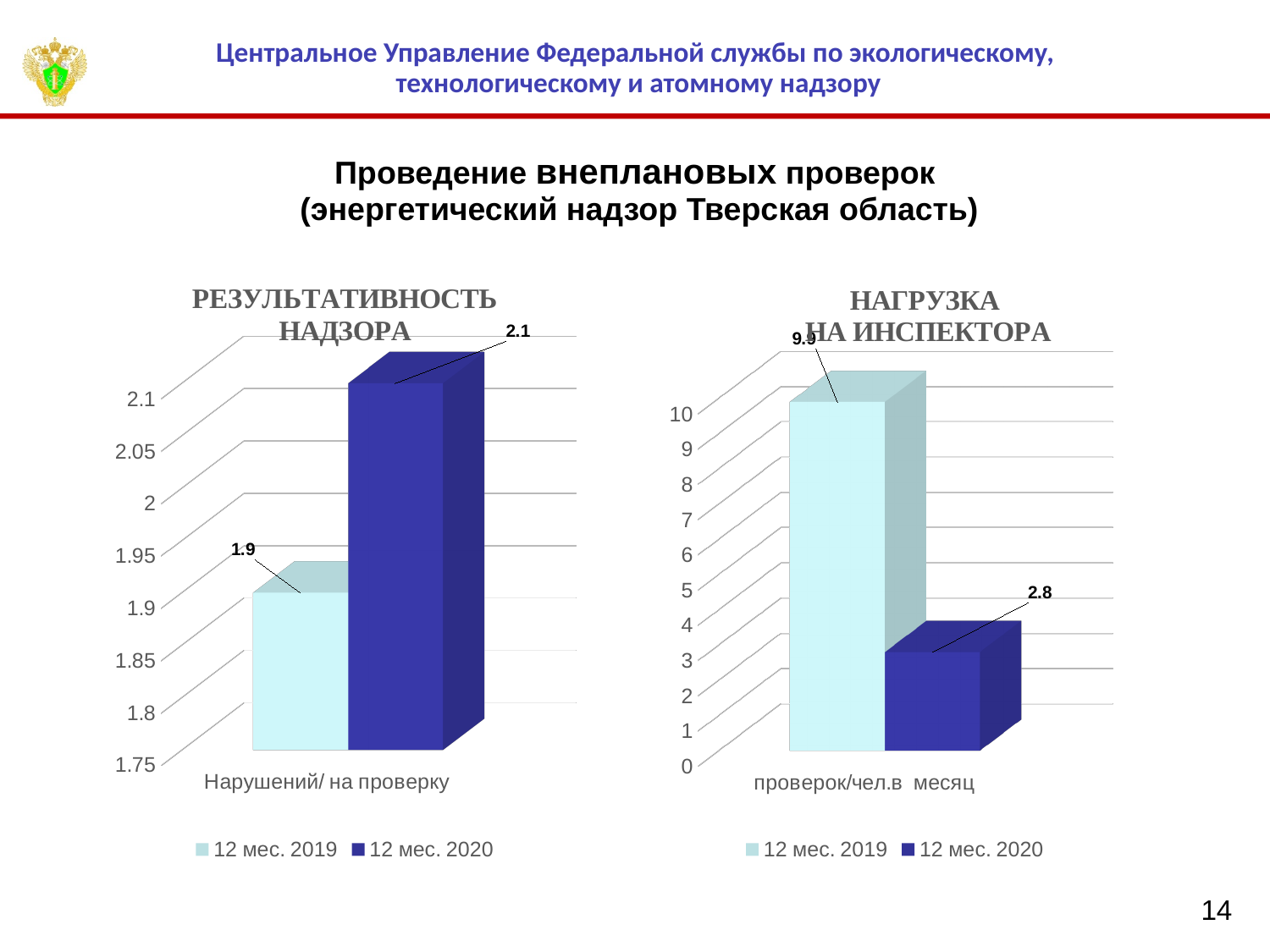
In the chart titled «НАГРУЗКА НА ИНСПЕКТОРА», which series has the lower value? 12 мес. 2020 What is the category label on the x axis of the chart titled «НАГРУЗКА НА ИНСПЕКТОРА»? проверок/чел.в месяц In the chart titled «РЕЗУЛЬТАТИВНОСТЬ НАДЗОРА», what is the value for «12 мес. 2020»? 2.1 In the chart titled «РЕЗУЛЬТАТИВНОСТЬ НАДЗОРА», what is the value for «12 мес. 2019»? 1.9 In the chart titled «РЕЗУЛЬТАТИВНОСТЬ НАДЗОРА», which series has the higher value? 12 мес. 2020 In the chart titled «НАГРУЗКА НА ИНСПЕКТОРА», is the value for «12 мес. 2019» greater or less than 9? greater In the chart titled «РЕЗУЛЬТАТИВНОСТЬ НАДЗОРА», what is the difference between the 2020 and 2019 values? 0.2 What kind of chart is the chart titled «РЕЗУЛЬТАТИВНОСТЬ НАДЗОРА»? Bar chart How many series does the legend of the chart titled «НАГРУЗКА НА ИНСПЕКТОРА» list? 2 In the chart titled «НАГРУЗКА НА ИНСПЕКТОРА», what is the difference between the 2019 and 2020 values? 7.1 In the chart titled «НАГРУЗКА НА ИНСПЕКТОРА», what is the value for «12 мес. 2020»? 2.8 In the chart titled «НАГРУЗКА НА ИНСПЕКТОРА», what is the value for «12 мес. 2019»? 9.9